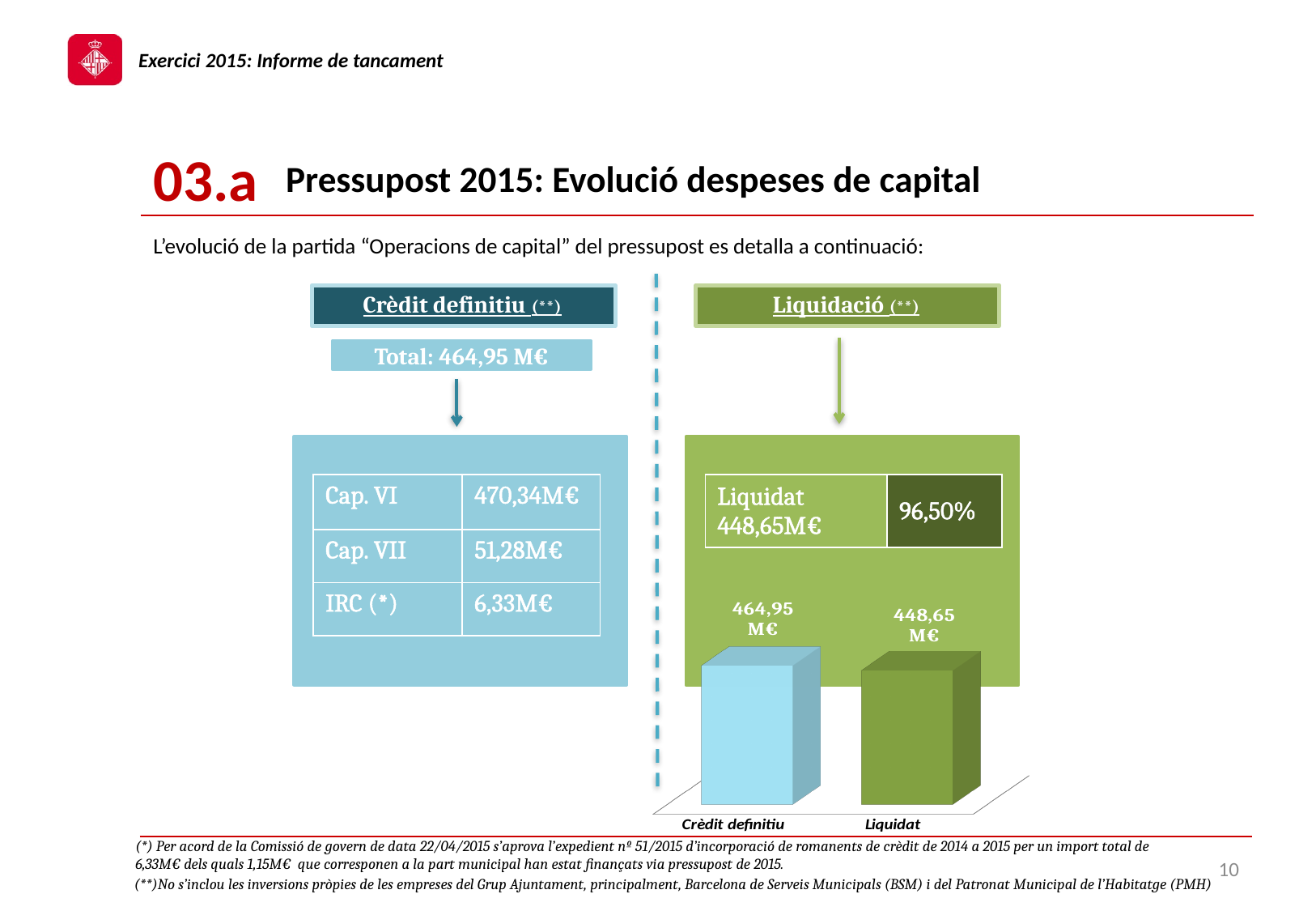
What is the value of the Crèdit definitiu bar? 464,95 M€ What is the difference between the Crèdit definitiu and Liquidat bars? 16,30 M€ What are the category labels shown under the bars of the chart? Crèdit definitiu and Liquidat Which bar is higher, Crèdit definitiu or Liquidat? Crèdit definitiu What colour is the Liquidat bar in the chart? green Which category has the highest value in the chart? Crèdit definitiu What kind of chart is shown at the bottom right of the slide? bar chart How many bars does the chart show? 2 Which category has the lowest value in the chart? Liquidat What is the value of the Liquidat bar? 448,65 M€